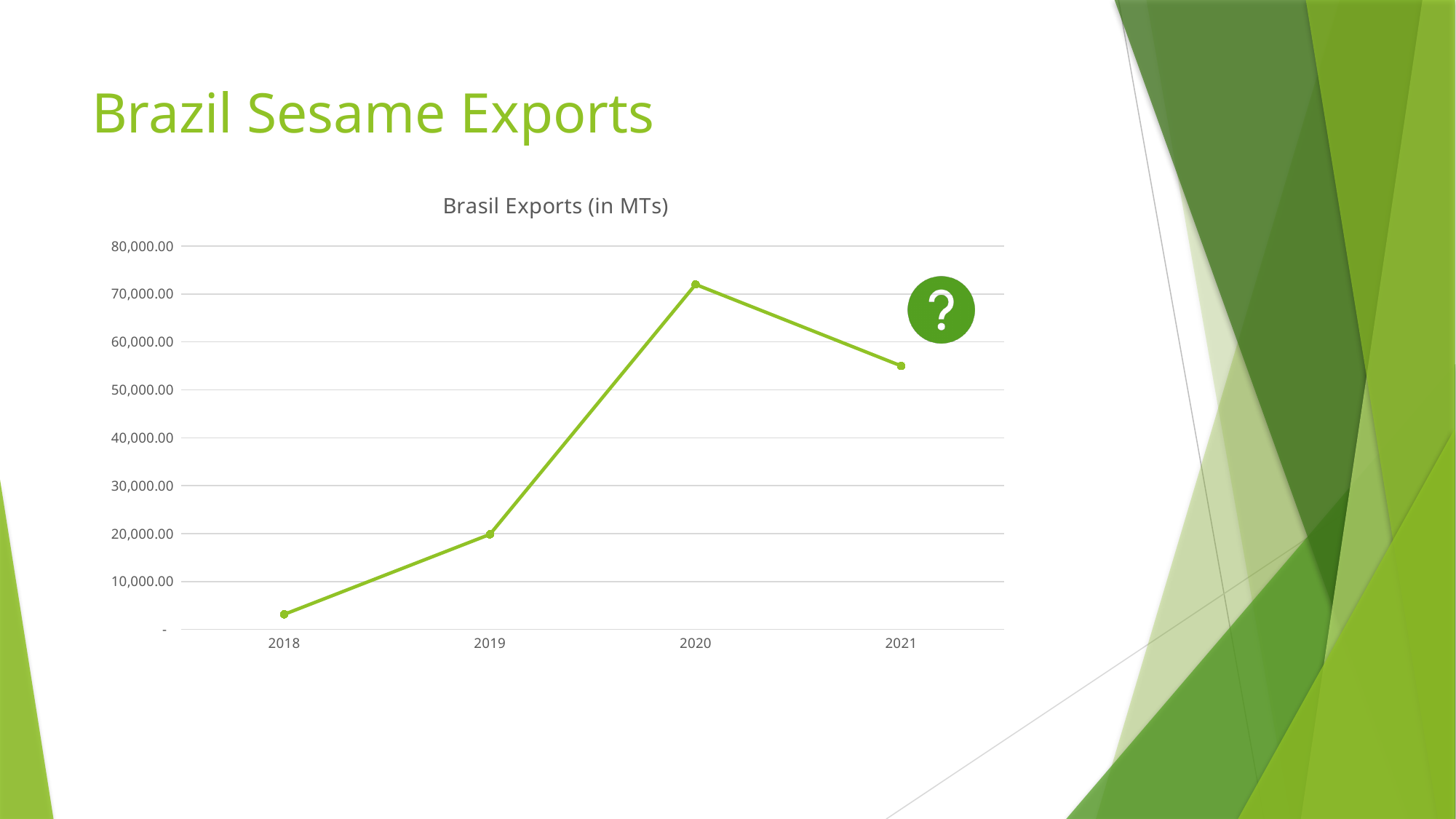
What is the title of the chart? Brasil Exports (in MTs) What kind of chart is shown on the slide? line chart Do the export values rise or fall from 2020 to 2021? fall Do the export values rise or fall from 2018 to 2020? rise Is the value for 2021 greater or less than 60,000.00? less Is the value for 2020 greater or less than 70,000.00? greater How many years are plotted on the x axis of the chart? 4 Which year has the lowest export value in the chart? 2018 Is the value for 2018 greater or less than 10,000.00? less Which year has the larger export value, 2019 or 2021? 2021 Which year has the highest export value in the chart? 2020